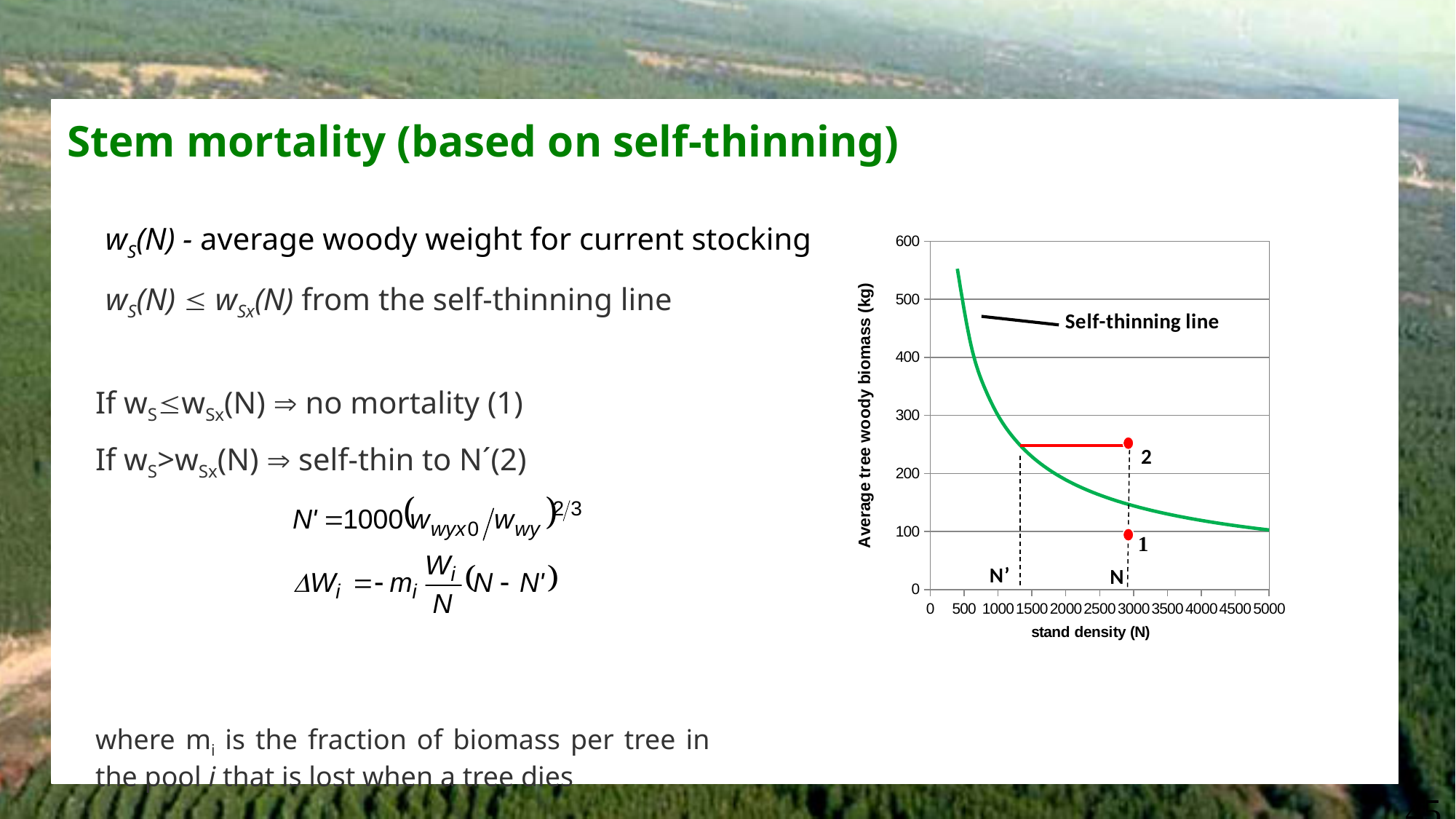
Is the value of the self-thinning line at a stand density of 4000 greater or less than 200? less What kind of chart is shown on the slide? line chart Is the average tree woody biomass at point 2 greater or less than 200? greater Is the average tree woody biomass at point 2 greater or less than 300? less Does the self-thinning line rise or fall as stand density increases? fall What is the highest value shown on the y axis of the chart? 600 What is the label of the y axis of the chart? Average tree woody biomass (kg) What is the label of the x axis of the chart? stand density (N) How many red points are marked on the chart? 2 Which red point has the higher average tree woody biomass, point 1 or point 2? point 2